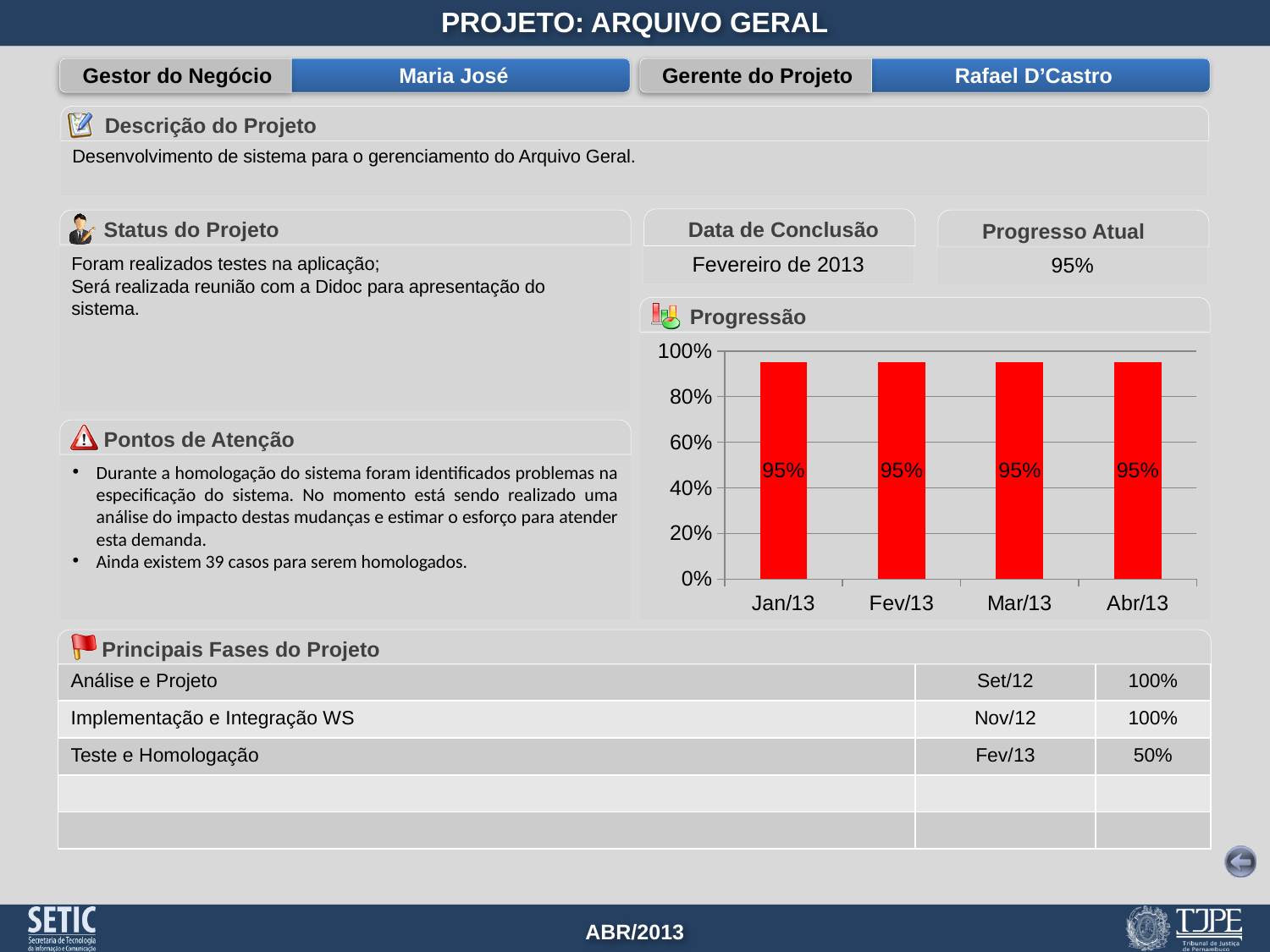
What is the value for Abr/13 in the Progressão chart? 95% What is the difference between the values for Jan/13 and Abr/13 in the Progressão chart? 0% What is the value for Jan/13 in the Progressão chart? 95% What colour are the bars in the Progressão chart? red What is the value for Mar/13 in the Progressão chart? 95% How many categories are shown on the x axis of the Progressão chart? 4 Do the values in the Progressão chart rise, fall or stay the same from Jan/13 to Abr/13? stay the same Is the value for Mar/13 in the Progressão chart greater or less than 80%? greater Is the value for Fev/13 in the Progressão chart greater or less than 100%? less What kind of chart is the Progressão chart? bar chart What is the title of the chart on the slide? Progressão What is the value for Fev/13 in the Progressão chart? 95%